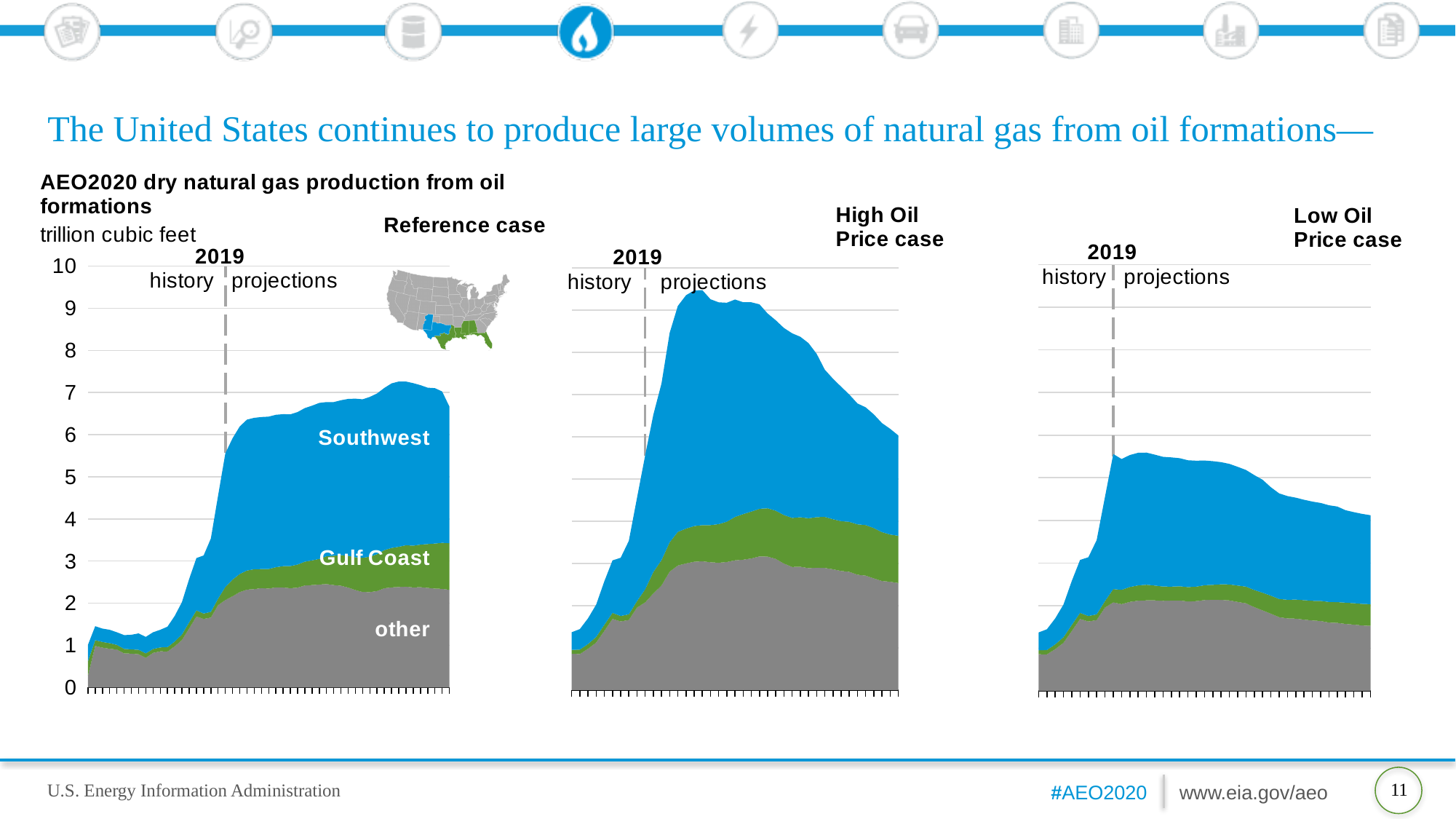
What kind of chart is used for the Reference case? stacked area chart Which of the three cases has the lowest total production at the end of the projection period? Low Oil Price case Which of the three cases reaches the highest peak total production? High Oil Price case In the High Oil Price case chart, is the peak total production greater or less than 9 trillion cubic feet? greater In the Reference case chart, which series is larger during the projection period, Southwest or Gulf Coast? Southwest In the High Oil Price case chart, does total production rise or fall after its peak in the projection period? fall What unit is used on the y axis of the charts? trillion cubic feet In the Reference case chart, is the 'other' series at the end of the projection period greater or less than 3 trillion cubic feet? less In the Low Oil Price case chart, is the peak total production greater or less than 6 trillion cubic feet? less Which year marks the boundary between history and projections in the charts? 2019 How many series are shown in each chart? 3